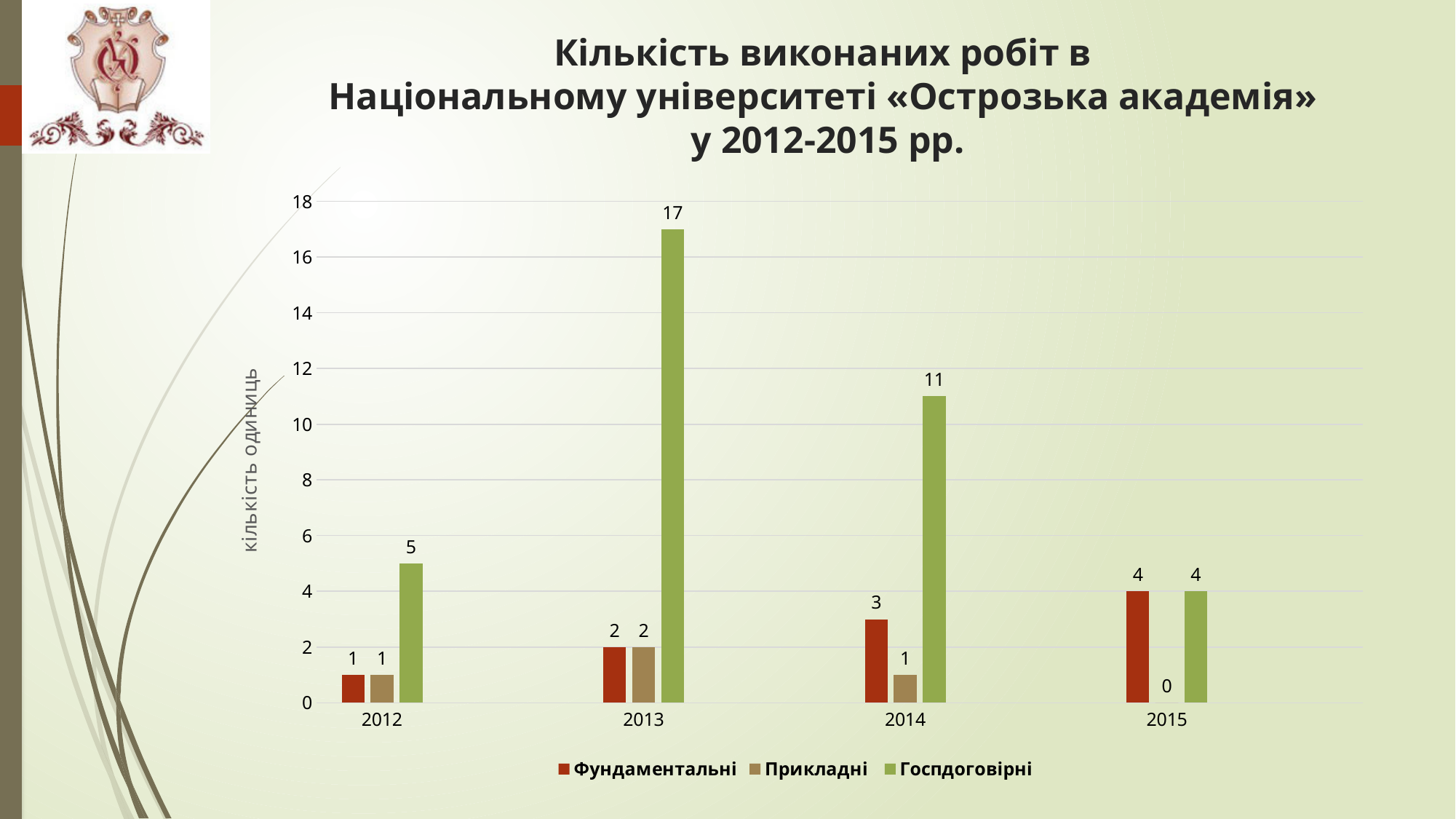
Which is larger in 2014: Фундаментальні or Госпдоговірні? Госпдоговірні How many years are shown on the x axis? 4 How many series does the legend list? 3 Does the value for Фундаментальні rise or fall from 2012 to 2015? rise Is the value for Госпдоговірні in 2014 greater or less than 10? greater What is the value for Госпдоговірні in 2013? 17 What is the value for Прикладні in 2014? 1 In which year is the value for Прикладні lowest? 2015 What is the difference between the Госпдоговірні values for 2013 and 2014? 6 What is the value for Фундаментальні in 2015? 4 In which year is the value for Госпдоговірні highest? 2013 What kind of chart is shown on the slide? bar chart